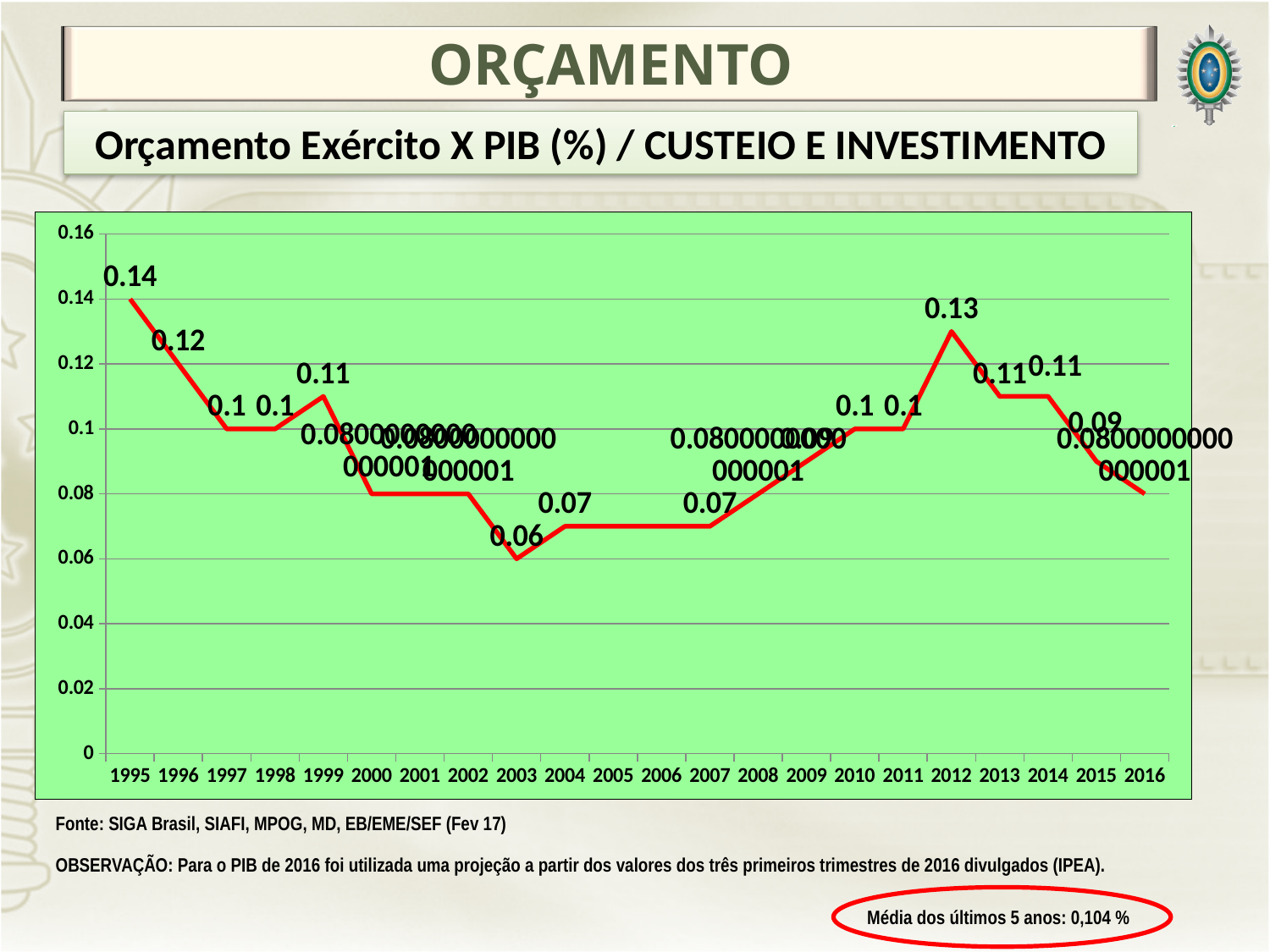
Do the values rise or fall from 1995 to 1997? fall What kind of chart is shown on the slide? line chart How many years are shown on the x axis? 22 What is the difference between the values for 1995 and 2003? 0.08 What is the value for 2015? 0.09 Which year has the larger value, 2012 or 2013? 2012 Is the value for 2005 greater or less than 0.08? less What colour is the line in the chart? red Which year has the highest value? 1995 What is the value for 2012? 0.13 Which year has the lowest value? 2003 What is the value for 1995? 0.14